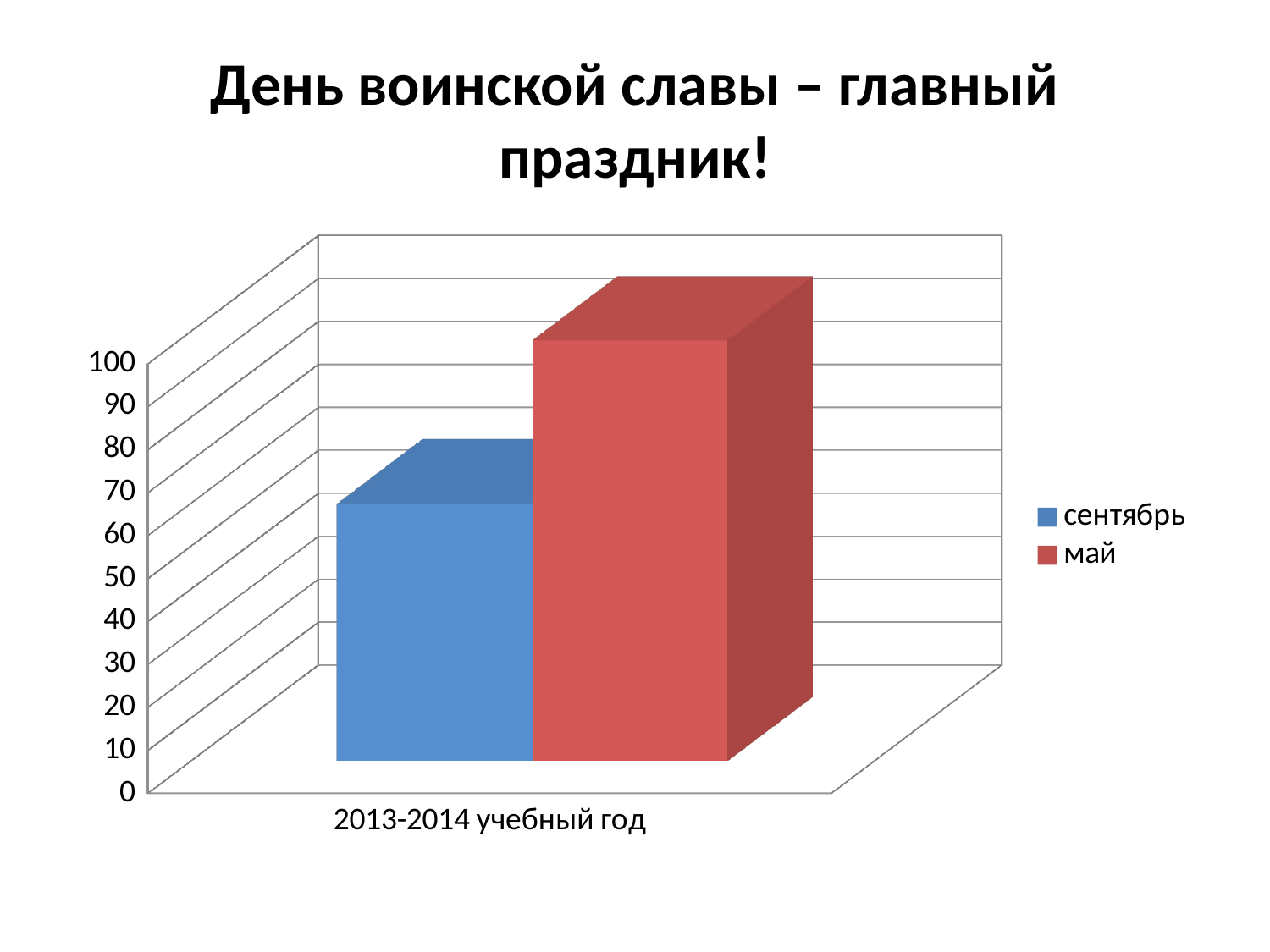
Is the value for сентябрь greater or less than 80? less Which series is shown in red? май Is the value for сентябрь greater or less than 40? greater Which series has the higher value, сентябрь or май? май What is the category label on the x axis? 2013-2014 учебный год How many series does the legend list? 2 Which series has the lowest value? сентябрь Is the value for май greater or less than 70? greater What kind of chart is shown on the slide? bar chart Which series has the highest value? май How many categories are shown on the x axis? 1